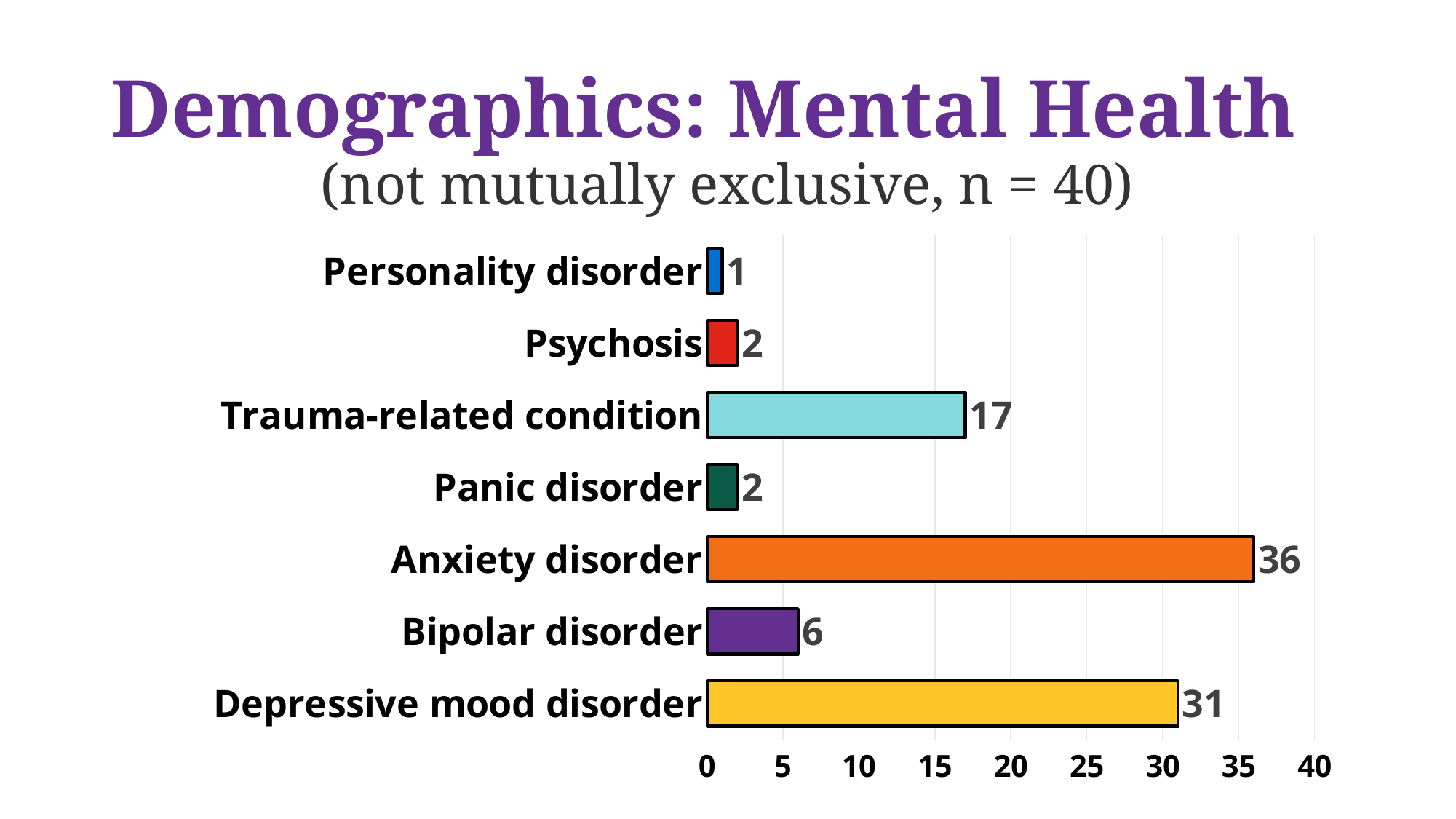
What is the title of the slide? Demographics: Mental Health Is the value for Depressive mood disorder greater or less than 25? greater What is the difference between the values for Anxiety disorder and Depressive mood disorder? 5 What kind of chart is shown on the slide? Bar chart What is the value for Anxiety disorder? 36 What is the value for Trauma-related condition? 17 Which category has the lowest value? Personality disorder Which category has the highest value? Anxiety disorder What is the difference between the values for Trauma-related condition and Psychosis? 15 What is the value for Bipolar disorder? 6 How many categories are shown in the chart? 7 Which is larger, the value for Trauma-related condition or the value for Bipolar disorder? Trauma-related condition